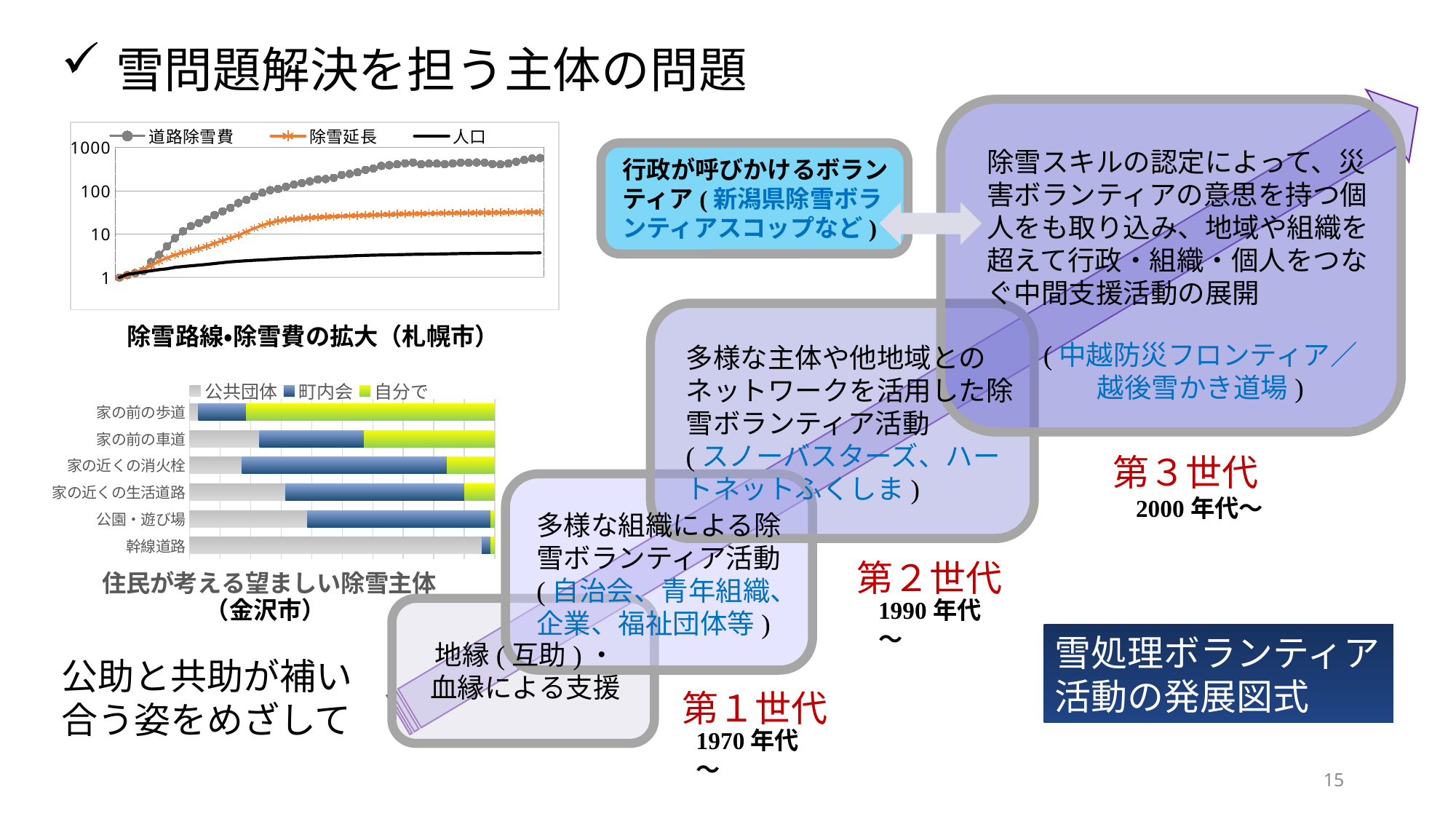
In the bottom-left chart (住民が考える望ましい除雪主体), which category has the largest 自分で segment? 家の前の歩道 In the top-left chart (除雪路線•除雪費の拡大), is the final value of 道路除雪費 greater or less than 100? greater What kind of chart is the top-left chart titled 除雪路線•除雪費の拡大（札幌市）? line chart In the bottom-left chart (住民が考える望ましい除雪主体), which category has the largest 公共団体 segment? 幹線道路 In the top-left chart (除雪路線•除雪費の拡大), which series has the lowest values at the right end of the x axis? 人口 What kind of chart is the bottom-left chart titled 住民が考える望ましい除雪主体（金沢市）? bar chart How many series does the legend of the top-left chart (除雪路線•除雪費の拡大) list? 3 How many categories does the bottom-left chart (住民が考える望ましい除雪主体) show? 6 In the top-left chart (除雪路線•除雪費の拡大), which series reaches the highest value at the right end of the x axis? 道路除雪費 In the top-left chart (除雪路線•除雪費の拡大), is the final value of 人口 greater or less than 10? less In the top-left chart (除雪路線•除雪費の拡大), do the values of 道路除雪費 rise or fall along the x axis? rise How many series does the legend of the bottom-left chart (住民が考える望ましい除雪主体) list? 3